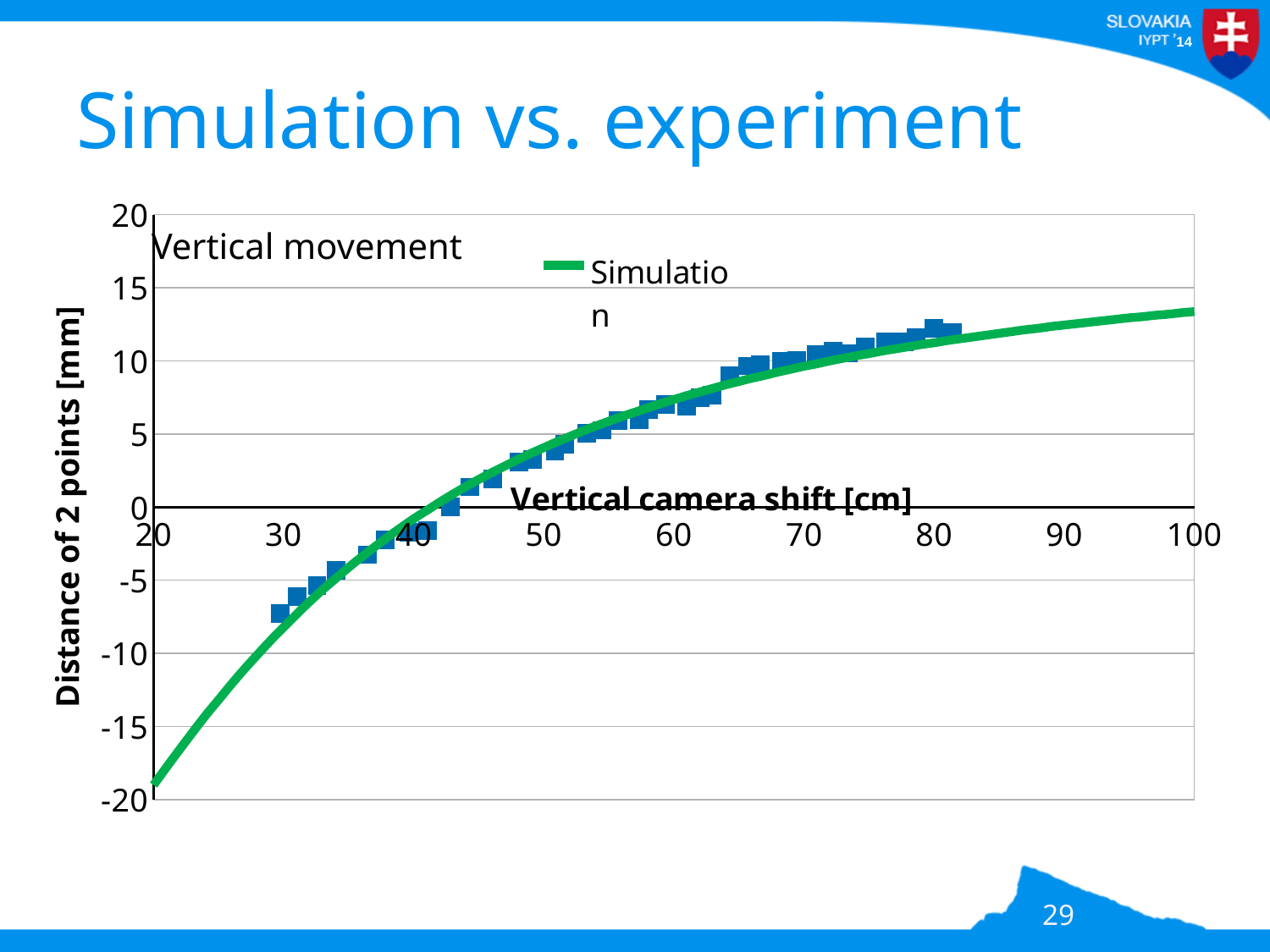
What is the title of the chart? Vertical movement Are the measured points at a vertical camera shift of 60 cm greater or less than 5? greater How many series does the legend list? 1 Is the value of the Simulation line at a vertical camera shift of 50 cm greater or less than 0? greater Are the measured points at a vertical camera shift of 30 cm greater or less than -5? less What kind of chart is shown on the slide? Scatter chart with a fitted line Do the values rise or fall as the vertical camera shift increases? Rise What is the label of the x axis? Vertical camera shift [cm] Which is larger, the value at a vertical camera shift of 30 cm or at 70 cm? 70 cm